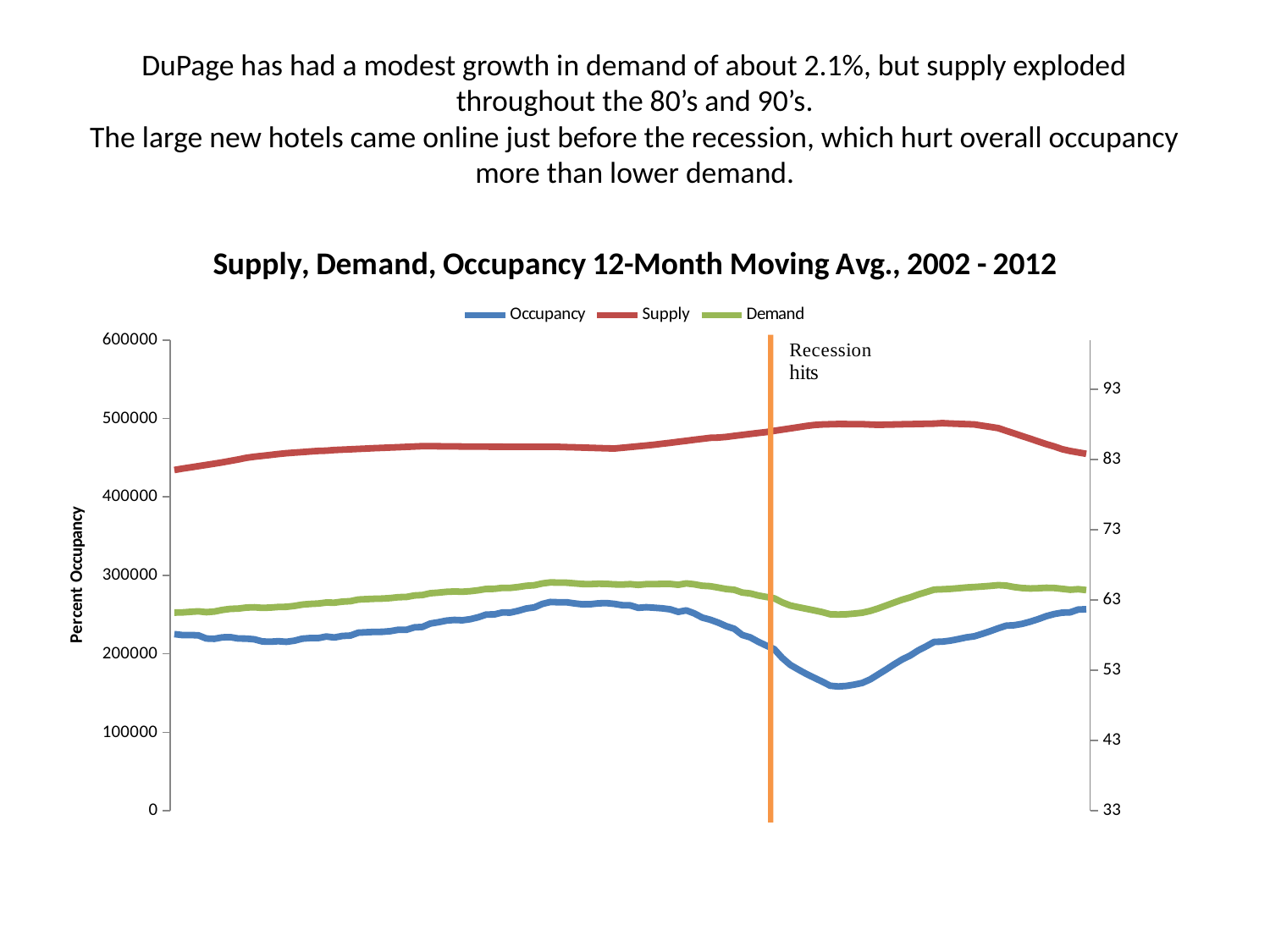
What is the title of the chart? Supply, Demand, Occupancy 12-Month Moving Avg., 2002 - 2012 Is the lowest point of the Occupancy line greater or less than 200000 on the left axis? less Does the Occupancy line rise or fall immediately after the recession line? fall Which is larger at the point where the recession line crosses the chart, Supply or Demand? Supply Is the highest point of the Demand line greater or less than 300000 on the left axis? less What does the label next to the vertical orange line on the chart say? Recession hits What kind of chart is shown on the slide? line chart Does the Supply line rise or fall from the left edge of the chart up to the recession line? rise Which series has the lowest values throughout the chart? Occupancy Which series has the highest values throughout the chart? Supply Is the value of the Supply line at the recession line greater or less than 400000 on the left axis? greater How many series does the legend list? 3